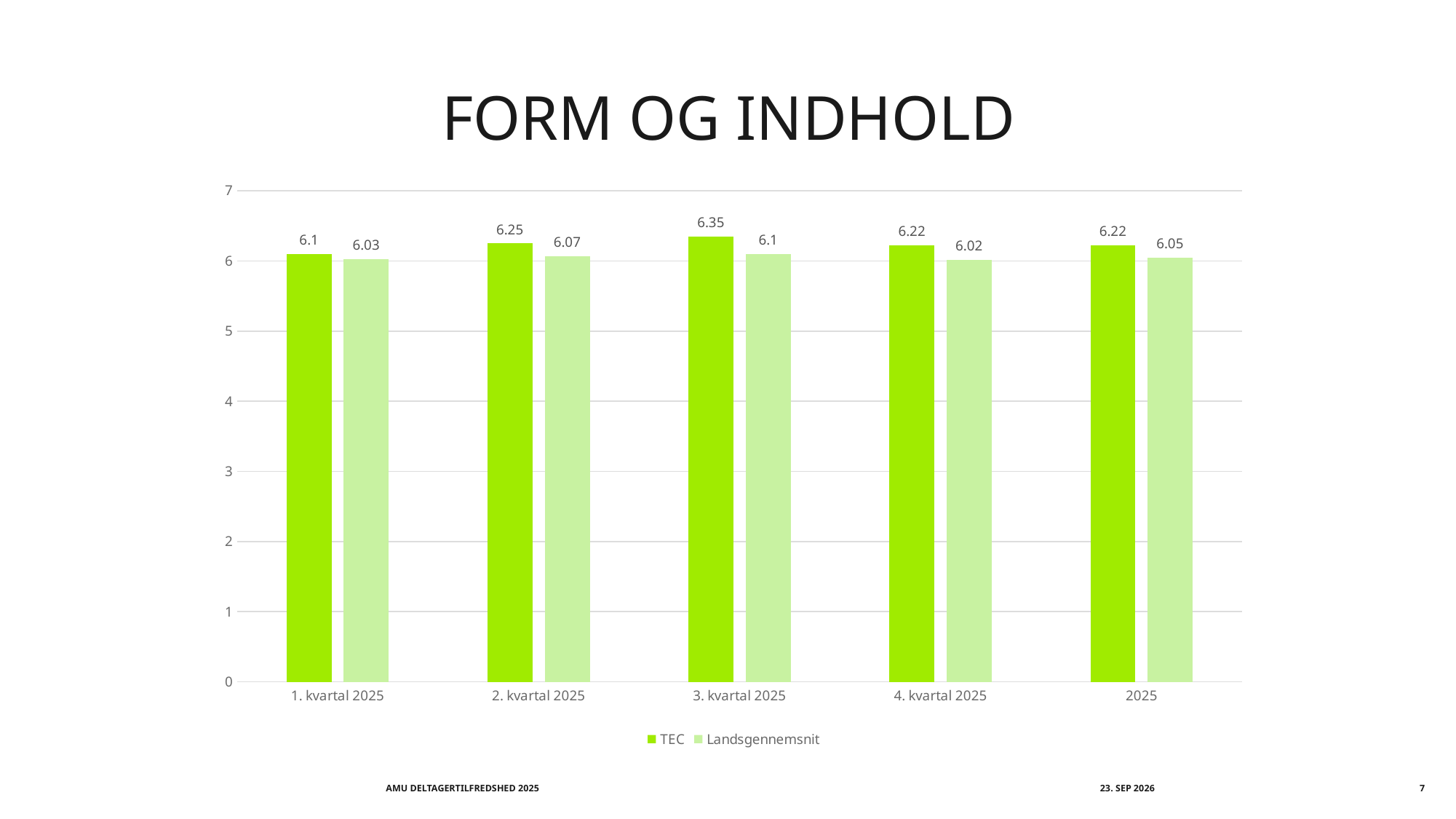
How many categories are shown on the x axis? 5 What is the TEC value for 3. kvartal 2025? 6.35 In which category is the TEC value highest? 3. kvartal 2025 What is the Landsgennemsnit value for 4. kvartal 2025? 6.02 How many series does the legend list? 2 What is the difference between the TEC and Landsgennemsnit values for 3. kvartal 2025? 0.25 What is the TEC value for 2025? 6.22 What kind of chart is shown on the slide? Bar chart What is the difference between the TEC values for 2. kvartal 2025 and 1. kvartal 2025? 0.15 Is the Landsgennemsnit value for 1. kvartal 2025 greater or less than 5? greater Which is larger for 2. kvartal 2025, the TEC value or the Landsgennemsnit value? TEC In which category is the TEC value lowest? 1. kvartal 2025